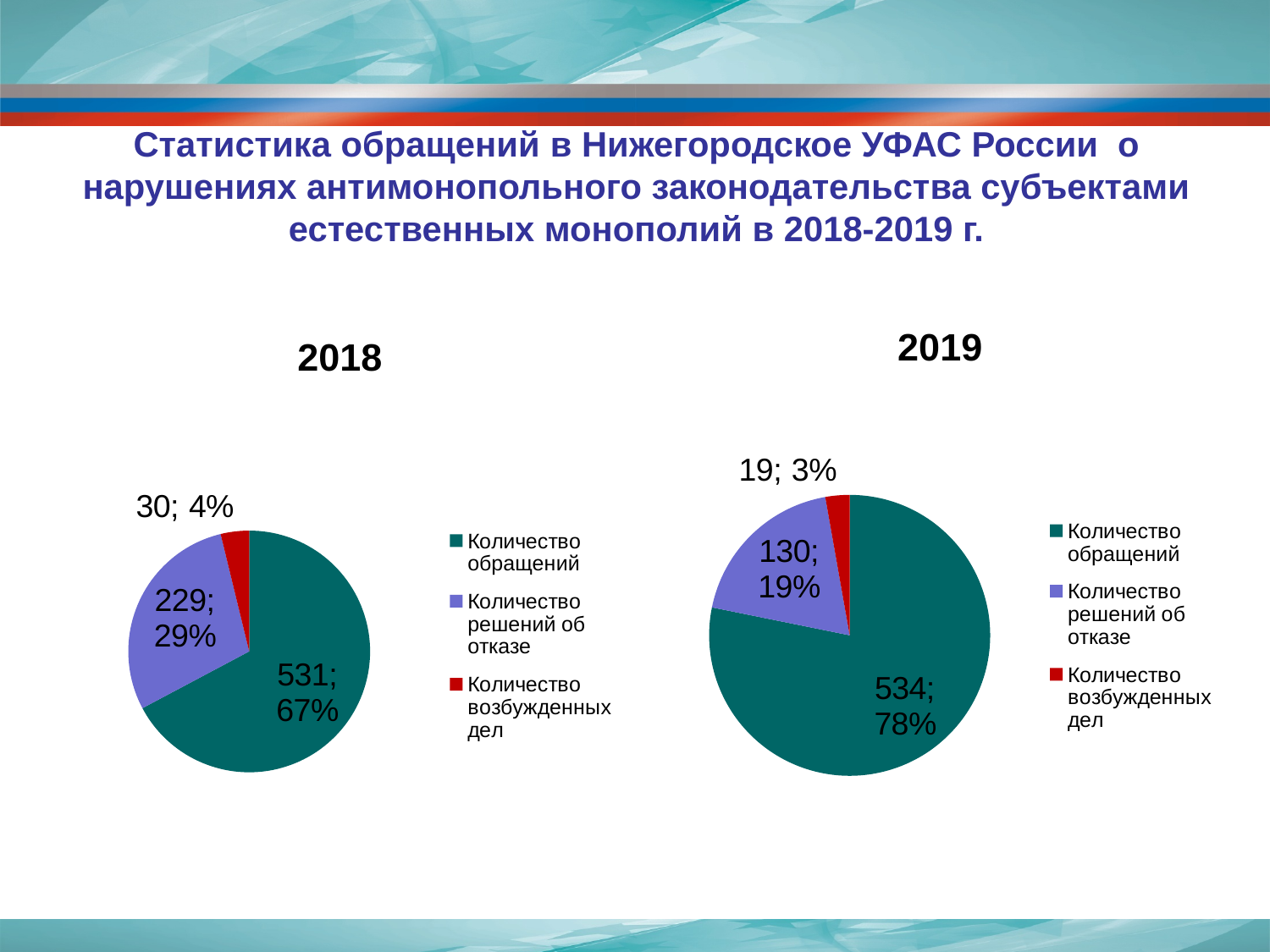
In the 2019 pie chart, what is the value for Количество обращений? 534 In the 2019 pie chart, which category has the smallest slice? Количество возбужденных дел In the 2018 pie chart, what is the value for Количество возбужденных дел? 30 What type of chart is used for the 2019 data? Pie chart Which is larger: Количество возбужденных дел in 2018 or in 2019? 2018 What is the difference between Количество решений об отказе in 2018 and in 2019? 99 In the 2018 pie chart, which category has the largest slice? Количество обращений How many categories does the legend of the 2018 chart list? 3 In the 2018 pie chart, what is the value for Количество обращений? 531 In the 2019 pie chart, what is the value for Количество решений об отказе? 130 In the 2018 pie chart, what share of the pie does Количество решений об отказе take? 29% In the 2019 pie chart, what share of the pie does Количество обращений take? 78%